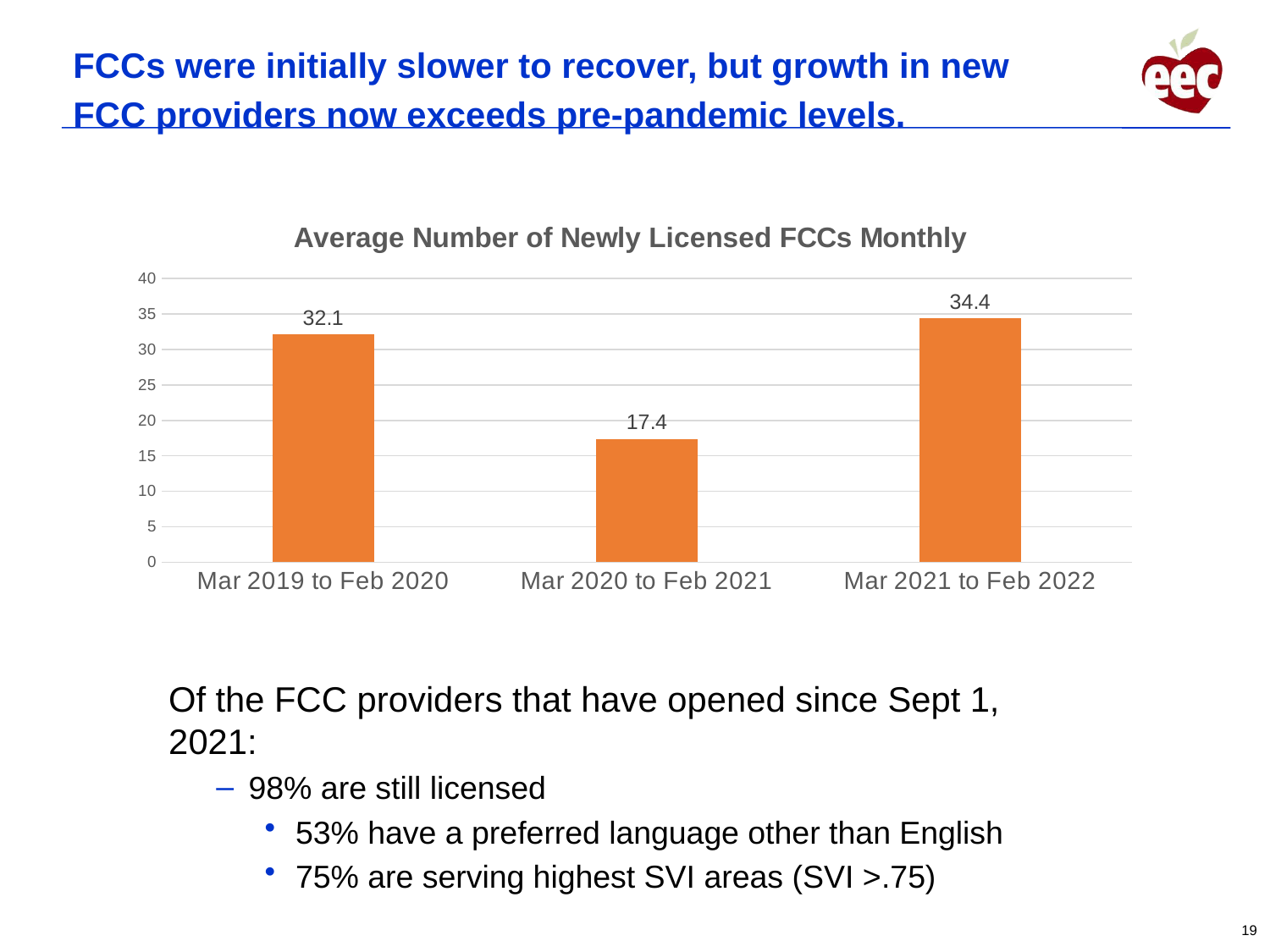
What kind of chart is shown on the slide? bar chart What is the average number of newly licensed FCCs monthly for Mar 2019 to Feb 2020? 32.1 Which is larger, the value for Mar 2019 to Feb 2020 or the value for Mar 2021 to Feb 2022? Mar 2021 to Feb 2022 Which period has the highest average number of newly licensed FCCs monthly? Mar 2021 to Feb 2022 What is the average number of newly licensed FCCs monthly for Mar 2020 to Feb 2021? 17.4 Which period has the lowest average number of newly licensed FCCs monthly? Mar 2020 to Feb 2021 Is the value for Mar 2020 to Feb 2021 greater or less than 20? less How many periods are shown on the chart? 3 What is the difference between the values for Mar 2019 to Feb 2020 and Mar 2020 to Feb 2021? 14.7 What is the difference between the values for Mar 2021 to Feb 2022 and Mar 2020 to Feb 2021? 17.0 What is the title of the chart? Average Number of Newly Licensed FCCs Monthly What is the average number of newly licensed FCCs monthly for Mar 2021 to Feb 2022? 34.4